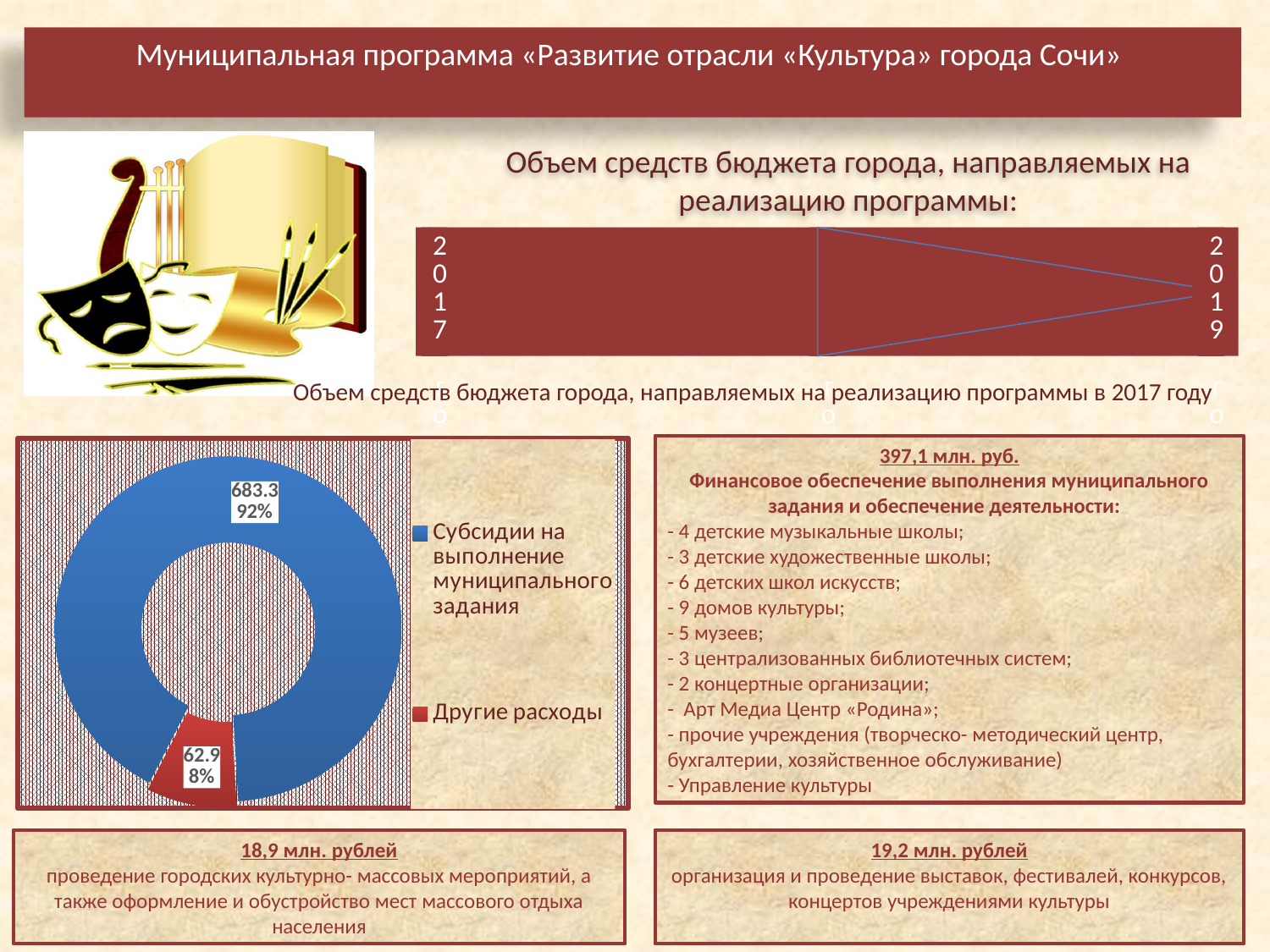
What value is shown for the "Субсидии на выполнение муниципального задания" slice of the doughnut chart? 683.3 What percentage share of the doughnut chart does "Другие расходы" represent? 8% How many categories does the doughnut chart show? 2 What is the difference between the values for "Субсидии на выполнение муниципального задания" and "Другие расходы" in the doughnut chart? 620.4 What colour is the "Другие расходы" slice in the doughnut chart? Red Which is larger in the doughnut chart: "Субсидии на выполнение муниципального задания" or "Другие расходы"? Субсидии на выполнение муниципального задания Which category in the doughnut chart has the smallest value? Другие расходы Which category in the doughnut chart has the largest value? Субсидии на выполнение муниципального задания What is the total of the two values shown in the doughnut chart? 746.2 What percentage share of the doughnut chart does "Субсидии на выполнение муниципального задания" represent? 92% What type of chart is used to show the budget breakdown on the slide? Doughnut (pie) chart What value is shown for the "Другие расходы" slice of the doughnut chart? 62.9